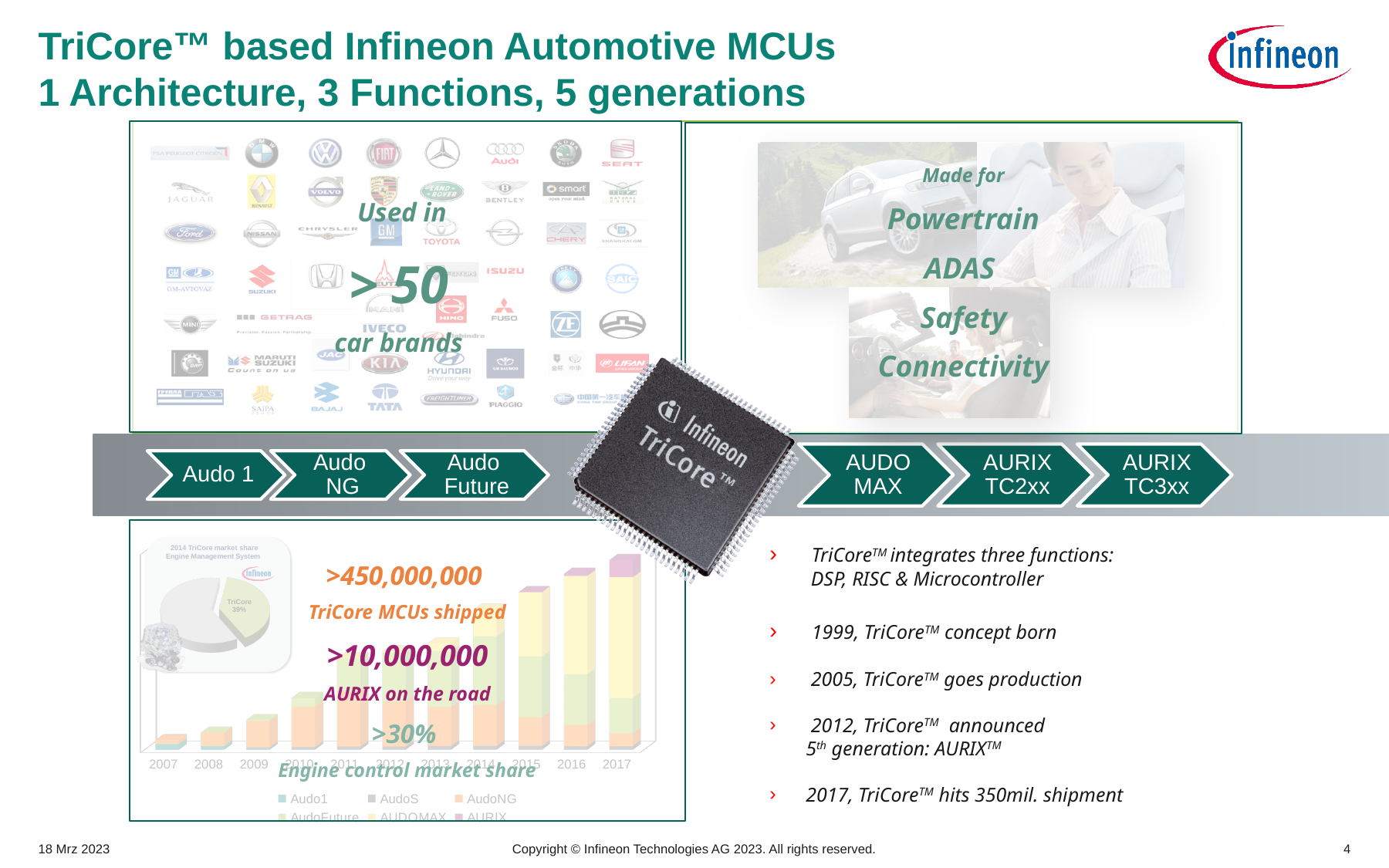
What kind of chart is shown in the lower-left panel of the slide, behind the text '>450,000,000 TriCore MCUs shipped'? stacked bar chart In the stacked bar chart in the lower-left panel, which year has the tallest bar? 2017 How many series does the legend of the stacked bar chart in the lower-left panel list? 6 In the stacked bar chart in the lower-left panel, how many years are shown on the x axis? 11 In the small pie chart inset in the lower-left panel titled '2014 TriCore market share Engine Management System', what share is labelled for TriCore? 39% In the stacked bar chart in the lower-left panel, what is the last year on the x axis? 2017 In the stacked bar chart in the lower-left panel, is the bar for 2016 taller or shorter than the bar for 2012? taller In the stacked bar chart in the lower-left panel, what is the first year on the x axis? 2007 In the stacked bar chart in the lower-left panel, which year has the shortest bar? 2007 In the stacked bar chart in the lower-left panel, do the bar totals rise or fall from 2007 to 2017? rise What kind of chart is the small inset in the upper-left corner of the lower-left panel? pie chart